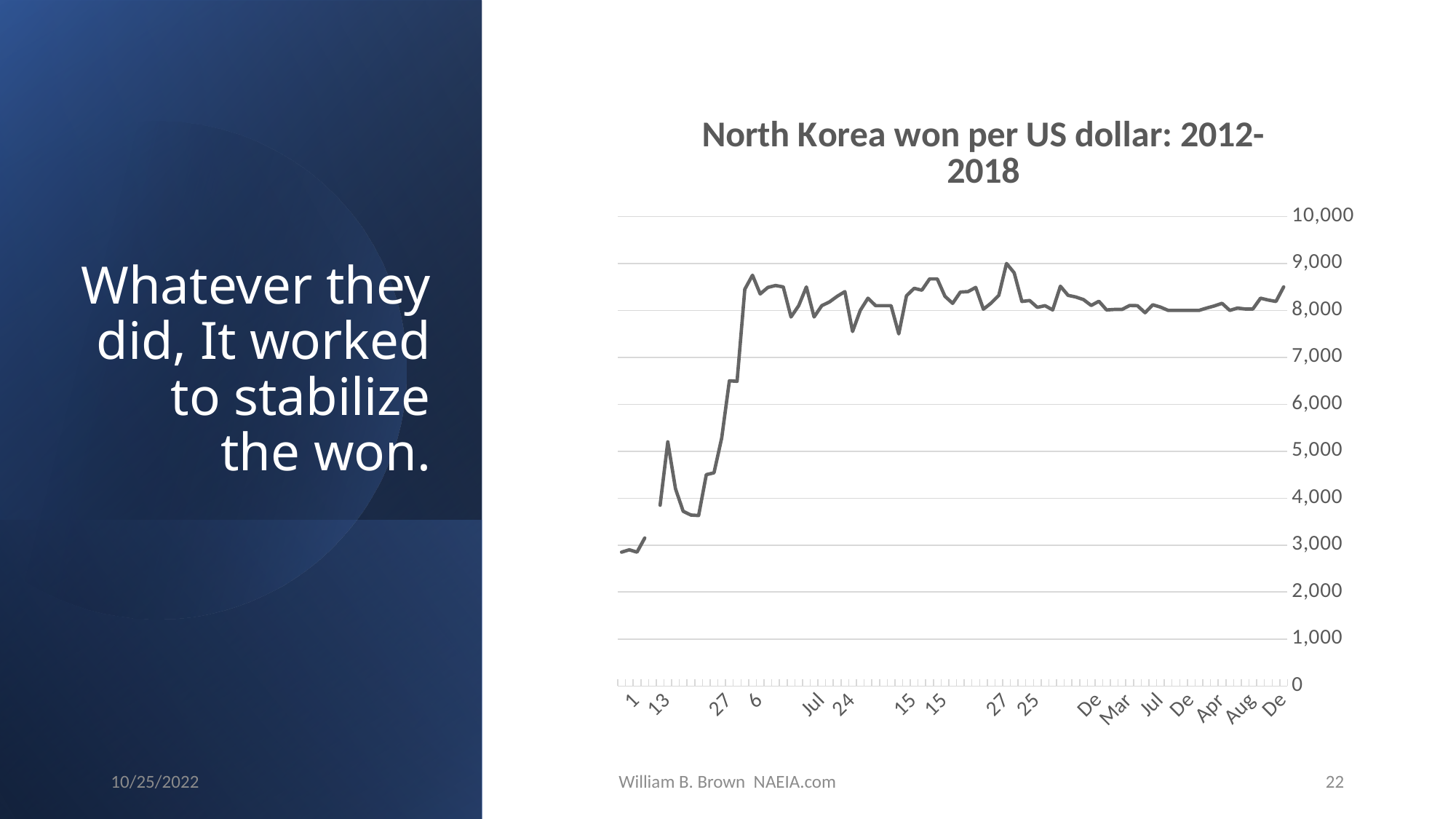
What is the highest value shown on the vertical axis of the chart? 10,000 Overall, does the won-per-dollar value rise or fall from the start of the series to the end? rise Is the value at the first point of the series greater or less than 3,000? less What type of chart is shown on the slide? line chart Is the value at the point labelled Jul (the first Jul) greater or less than 7,000? greater Is the value at the point labelled 27 (the first 27) larger or smaller than the value at the point labelled Jul (the first Jul)? smaller What is the title of the chart? North Korea won per US dollar: 2012-2018 Is the value at the last point of the series (labelled De) greater or less than 8,000? greater Is the value at the point labelled 1 on the x axis larger or smaller than the value at the point labelled 6? smaller Does the series rise or fall between the point labelled 13 and the point labelled 6? rise